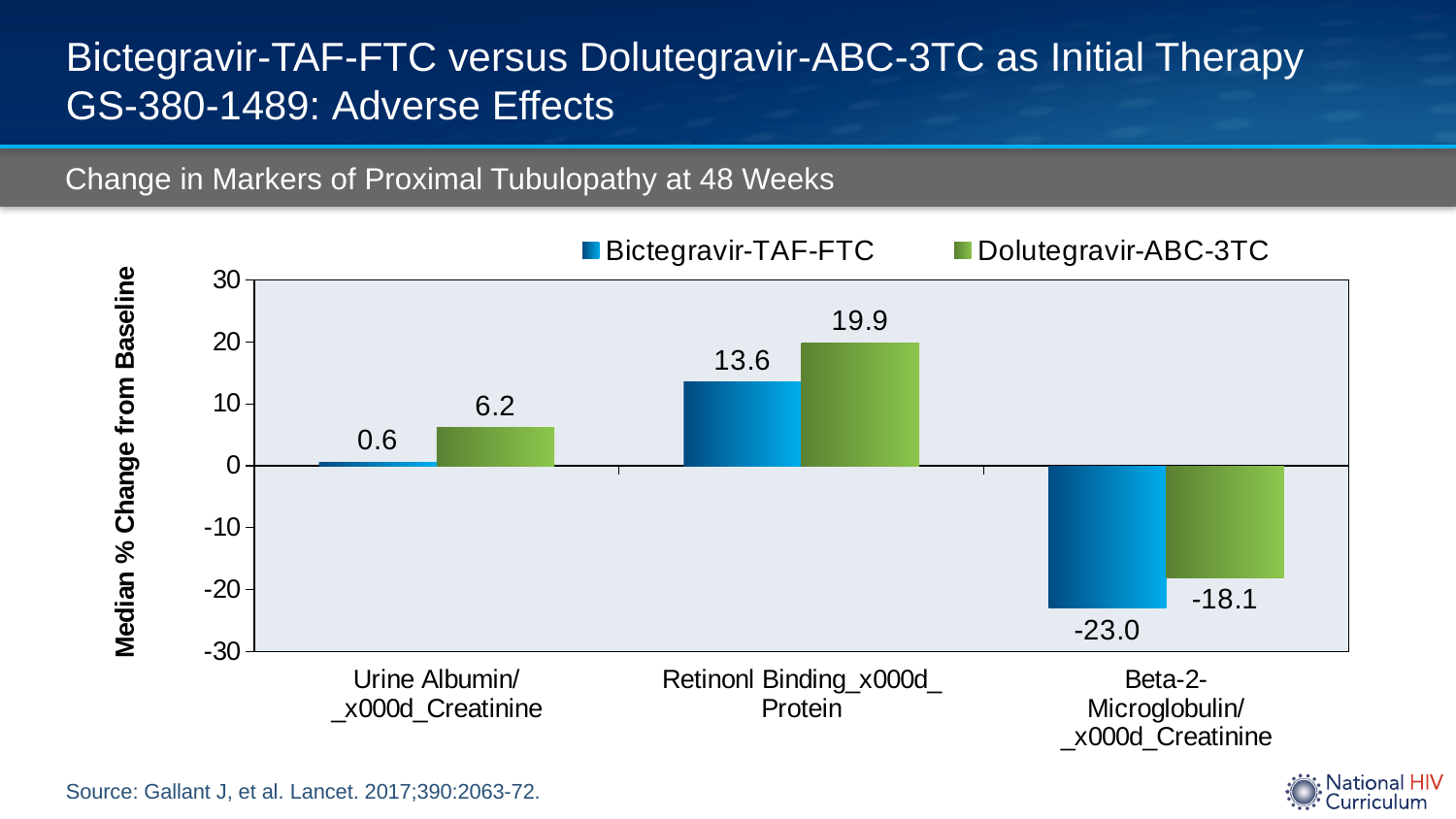
What is the median % change from baseline for Bictegravir-TAF-FTC in Beta-2-Microglobulin/Creatinine? -23.0 What is the difference between the Dolutegravir-ABC-3TC and Bictegravir-TAF-FTC values for Retinol Binding Protein? 6.3 What kind of chart is shown on the slide? Bar chart What is the median % change from baseline for Bictegravir-TAF-FTC in Retinol Binding Protein? 13.6 What is the median % change from baseline for Dolutegravir-ABC-3TC in Urine Albumin/Creatinine? 6.2 How many series does the chart legend list? 2 What is the median % change from baseline for Dolutegravir-ABC-3TC in Beta-2-Microglobulin/Creatinine? -18.1 For Urine Albumin/Creatinine, which series has the larger value, Bictegravir-TAF-FTC or Dolutegravir-ABC-3TC? Dolutegravir-ABC-3TC Is the Bictegravir-TAF-FTC value for Beta-2-Microglobulin/Creatinine greater or less than -20? less Which category has the highest value for Dolutegravir-ABC-3TC? Retinol Binding Protein How many categories are shown on the x axis of the chart? 3 Which category has the lowest value for Bictegravir-TAF-FTC? Beta-2-Microglobulin/Creatinine